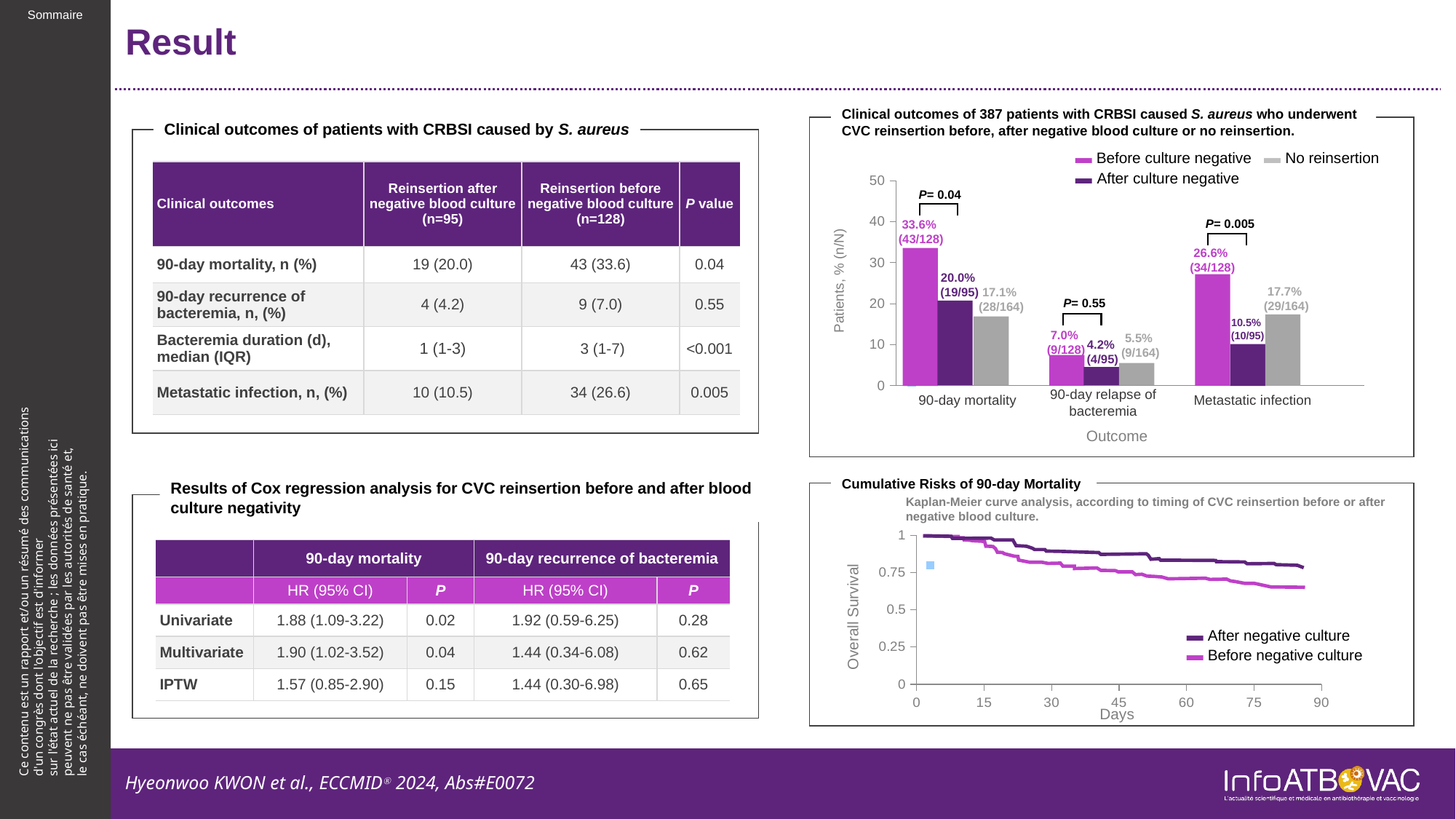
In the bar chart of clinical outcomes of 387 patients, what is the value for 'After culture negative' for 90-day relapse of bacteremia? 4.2% In the bar chart of clinical outcomes of 387 patients, which outcome has the highest value for 'Before culture negative'? 90-day mortality In the bar chart of clinical outcomes of 387 patients, how many series does the legend list? 3 In the bar chart of clinical outcomes of 387 patients, what is the value for 'No reinsertion' for metastatic infection? 17.7% In the bar chart of clinical outcomes of 387 patients, which outcome has the lowest value for 'No reinsertion'? 90-day relapse of bacteremia In the bar chart of clinical outcomes of 387 patients, how many outcome categories are shown on the x axis? 3 In the 'Cumulative Risks of 90-day Mortality' chart, is the overall survival for 'Before negative culture' at day 75 greater or less than 0.75? less In the bar chart of clinical outcomes of 387 patients, what is the difference between 'Before culture negative' and 'After culture negative' for 90-day mortality? 13.6% What kind of chart is 'Cumulative Risks of 90-day Mortality'? line chart In the bar chart of clinical outcomes of 387 patients, what is the value for 'Before culture negative' for 90-day mortality? 33.6% In the bar chart of clinical outcomes of 387 patients, which is larger for metastatic infection: 'After culture negative' or 'No reinsertion'? No reinsertion In the bar chart of clinical outcomes of 387 patients, what P value is shown for metastatic infection? 0.005